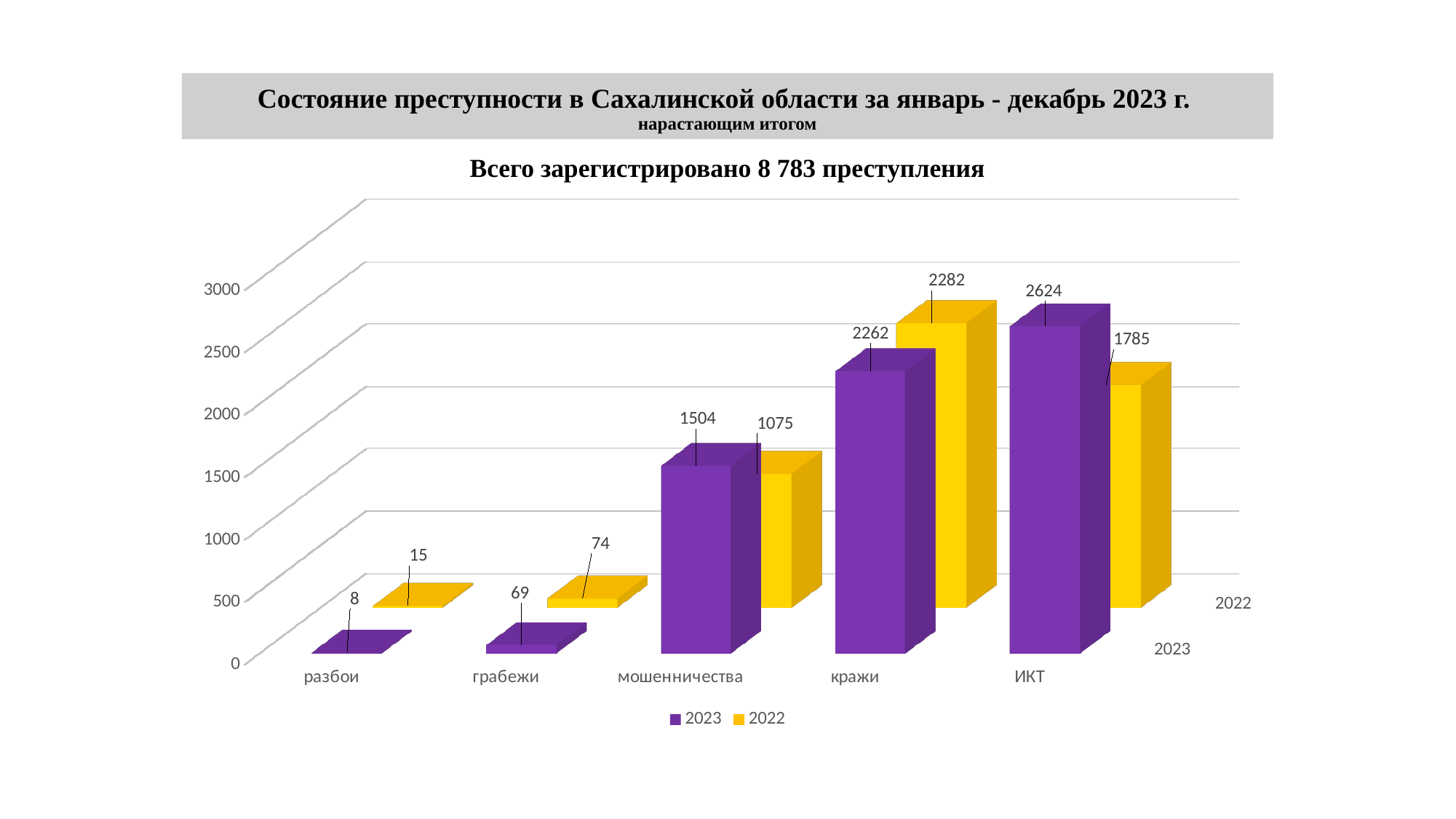
What is the value for разбои in the 2022 series? 15 What is the difference between the 2023 and 2022 values for ИКТ? 839 What is the value for кражи in the 2022 series? 2282 What is the value for ИКТ in the 2023 series? 2624 What kind of chart is shown on the slide? bar chart What is the value for мошенничества in the 2023 series? 1504 Which category has the highest value in the 2023 series? ИКТ Which category has the lowest value in the 2022 series? разбои How many categories are shown on the x axis? 5 For кражи, which series has the larger value, 2023 or 2022? 2022 How many series does the legend list? 2 What total number of registered crimes is stated above the chart? 8 783